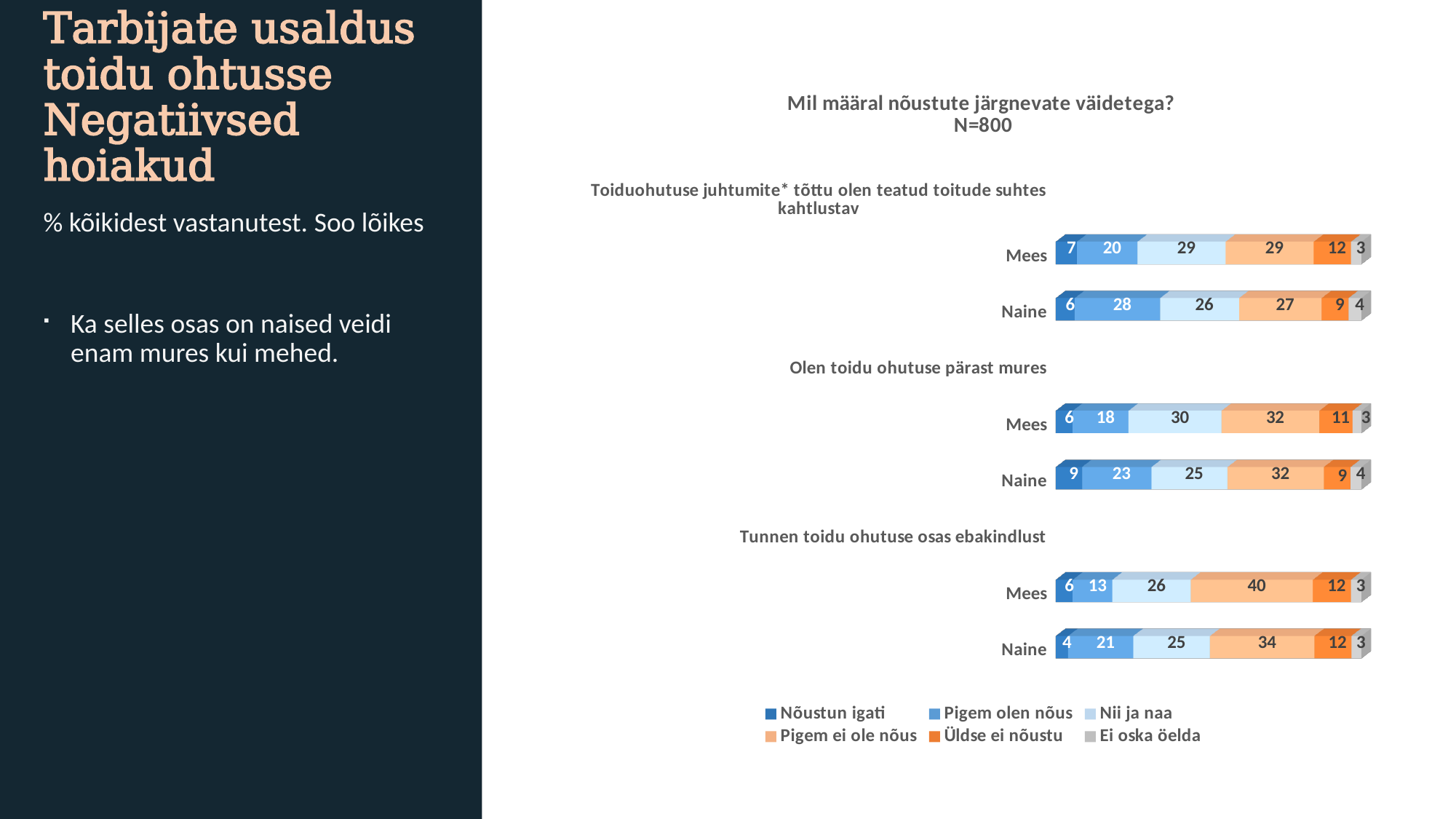
What is the total of the Mees bar for the statement "Toiduohutuse juhtumite* tõttu olen teatud toitude suhtes kahtlustav"? 100 For the statement "Olen toidu ohutuse pärast mures", which has the larger "Nii ja naa" value, Mees or Naine? Mees For the statement "Tunnen toidu ohutuse osas ebakindlust", what is the "Pigem ei ole nõus" value for Mees? 40 For the statement "Olen toidu ohutuse pärast mures", what is the "Pigem olen nõus" value for Naine? 23 How many series does the legend list? 6 Which legend entry is shown in dark orange? Üldse ei nõustu What is the title of the chart? Mil määral nõustute järgnevate väidetega? N=800 How many bars are plotted in the chart? 6 For the statement "Toiduohutuse juhtumite* tõttu olen teatud toitude suhtes kahtlustav", what is the difference between the "Pigem olen nõus" values for Naine and Mees? 8 What kind of chart is shown on the slide? stacked bar chart For the statement "Tunnen toidu ohutuse osas ebakindlust", which response category has the largest share in the Mees bar? Pigem ei ole nõus For the statement "Toiduohutuse juhtumite* tõttu olen teatud toitude suhtes kahtlustav", what is the "Üldse ei nõustu" value for Naine? 9